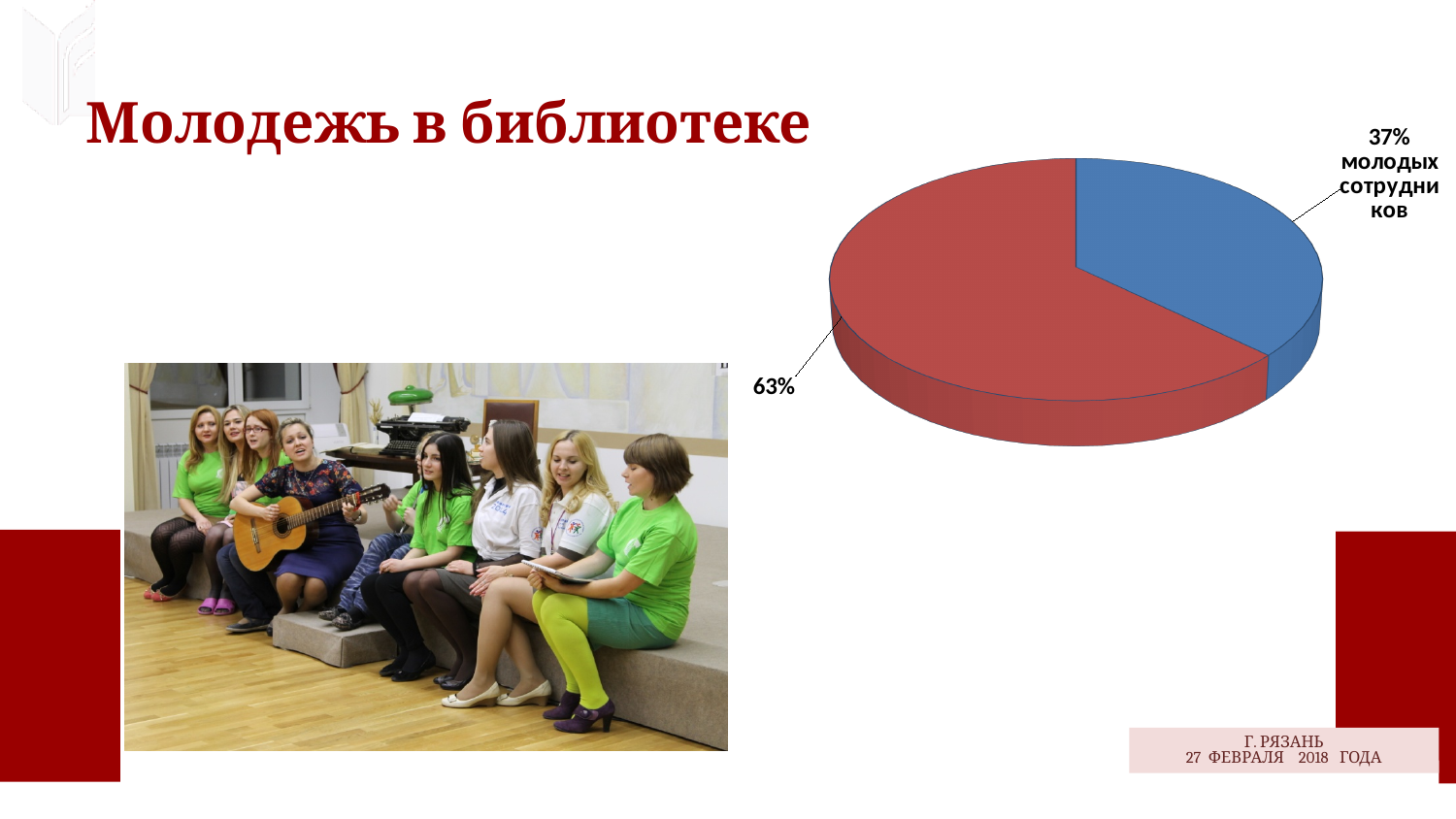
How many slices does the pie chart have? 2 Which is larger: the red slice or the blue slice? the red slice What is the difference in percentage points between the 63% slice and the 37% slice? 26 Which slice of the pie chart is the largest? the red slice (63%) What kind of chart is shown on the slide? pie chart Is the share of young employees (молодых сотрудников) greater or less than 50%? less What colour is the slice representing young employees (молодых сотрудников)? blue Which slice of the pie chart is the smallest? the blue slice (37% молодых сотрудников) What share of the pie is labelled "молодых сотрудников"? 37% What percentage is shown for the red slice of the pie chart? 63% What is the title of the slide containing the pie chart? Молодежь в библиотеке What percentage is shown for the blue slice of the pie chart? 37%